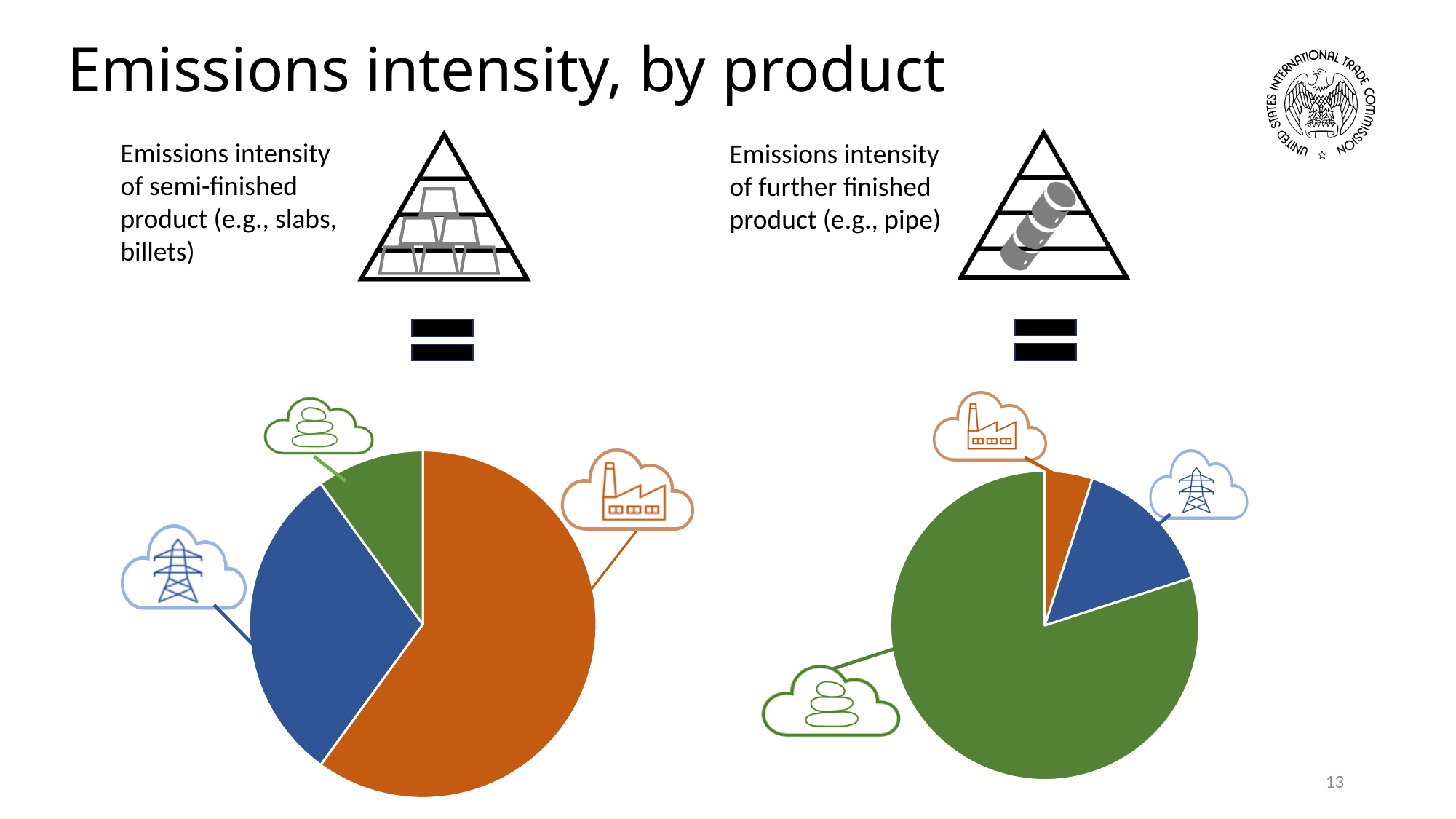
In the right pie chart (further finished product), which colour slice is the smallest? orange How many pie charts are shown on the slide? 2 How many slices does the left pie chart (semi-finished product) have? 3 What kind of chart is the left chart (emissions intensity of semi-finished product)? pie chart What kind of chart is the right chart (emissions intensity of further finished product)? pie chart In the left pie chart (semi-finished product), which colour slice is the smallest? green In the left pie chart (semi-finished product), which is larger, the blue slice or the green slice? blue What is the title of the slide containing the two pie charts? Emissions intensity, by product In the left pie chart (semi-finished product), which colour slice is the largest? orange How many slices does the right pie chart (further finished product) have? 3 In the right pie chart (further finished product), which is larger, the blue slice or the orange slice? blue In the right pie chart (further finished product), which colour slice is the largest? green